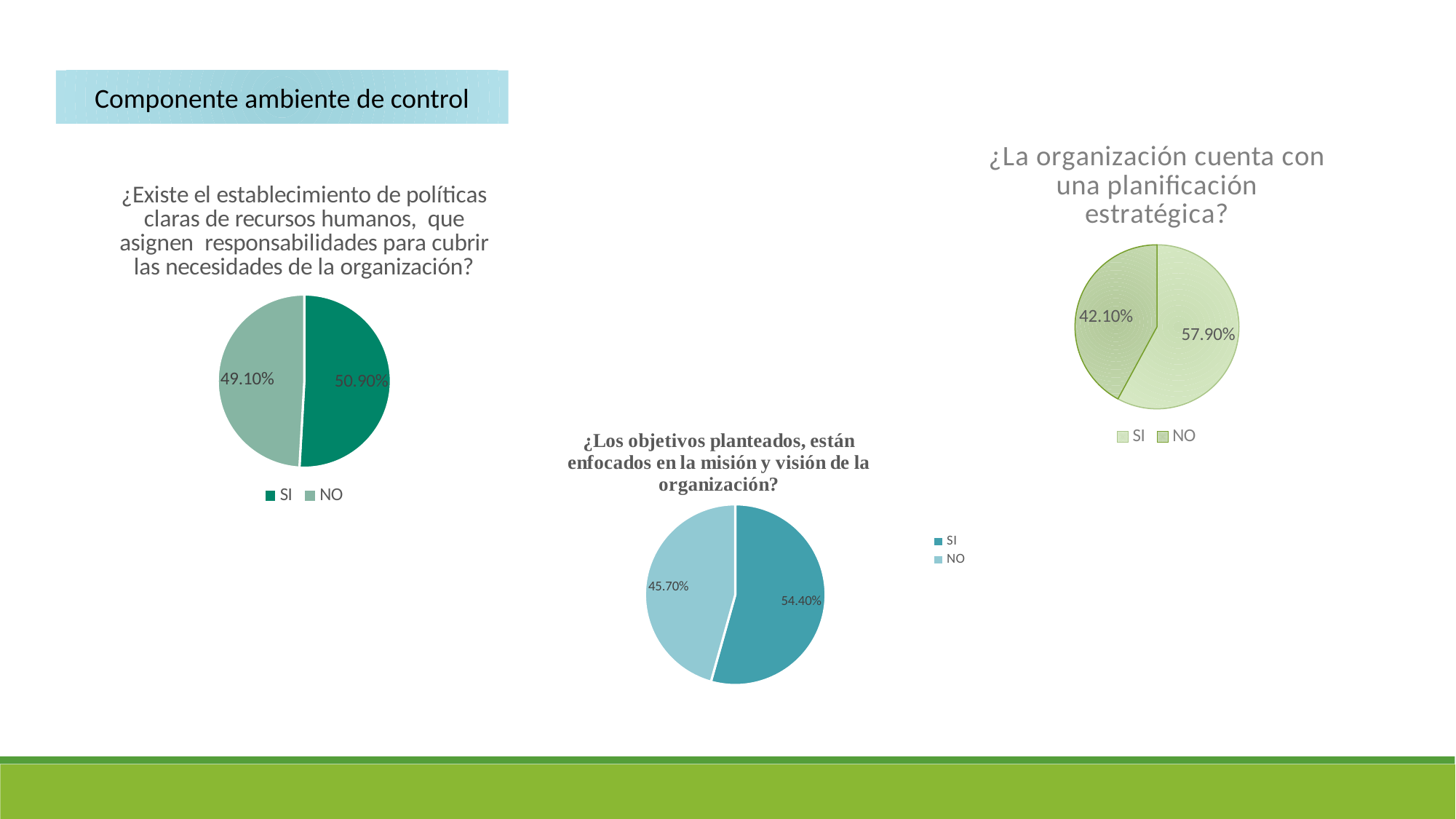
In the chart titled '¿Existe el establecimiento de políticas claras de recursos humanos...?', what is the value for NO? 49.10% In the chart titled '¿Los objetivos planteados, están enfocados en la misión y visión de la organización?', what is the difference between the SI and NO values? 8.70% In the chart titled '¿La organización cuenta con una planificación estratégica?', what is the difference between the SI and NO values? 15.80% In the chart titled '¿Los objetivos planteados, están enfocados en la misión y visión de la organización?', what is the value for NO? 45.70% In the chart titled '¿La organización cuenta con una planificación estratégica?', what is the value for NO? 42.10% What kind of chart is used for '¿Existe el establecimiento de políticas claras de recursos humanos...?'? Pie chart How many series does the legend list in the chart titled '¿La organización cuenta con una planificación estratégica?'? 2 In the chart titled '¿La organización cuenta con una planificación estratégica?', which category has the largest slice? SI In the chart titled '¿Existe el establecimiento de políticas claras de recursos humanos...?', what is the value for SI? 50.90% In the chart titled '¿Los objetivos planteados, están enfocados en la misión y visión de la organización?', what is the value for SI? 54.40% In the chart titled '¿Los objetivos planteados, están enfocados en la misión y visión de la organización?', which category has the smallest slice? NO In the chart titled '¿La organización cuenta con una planificación estratégica?', what is the value for SI? 57.90%